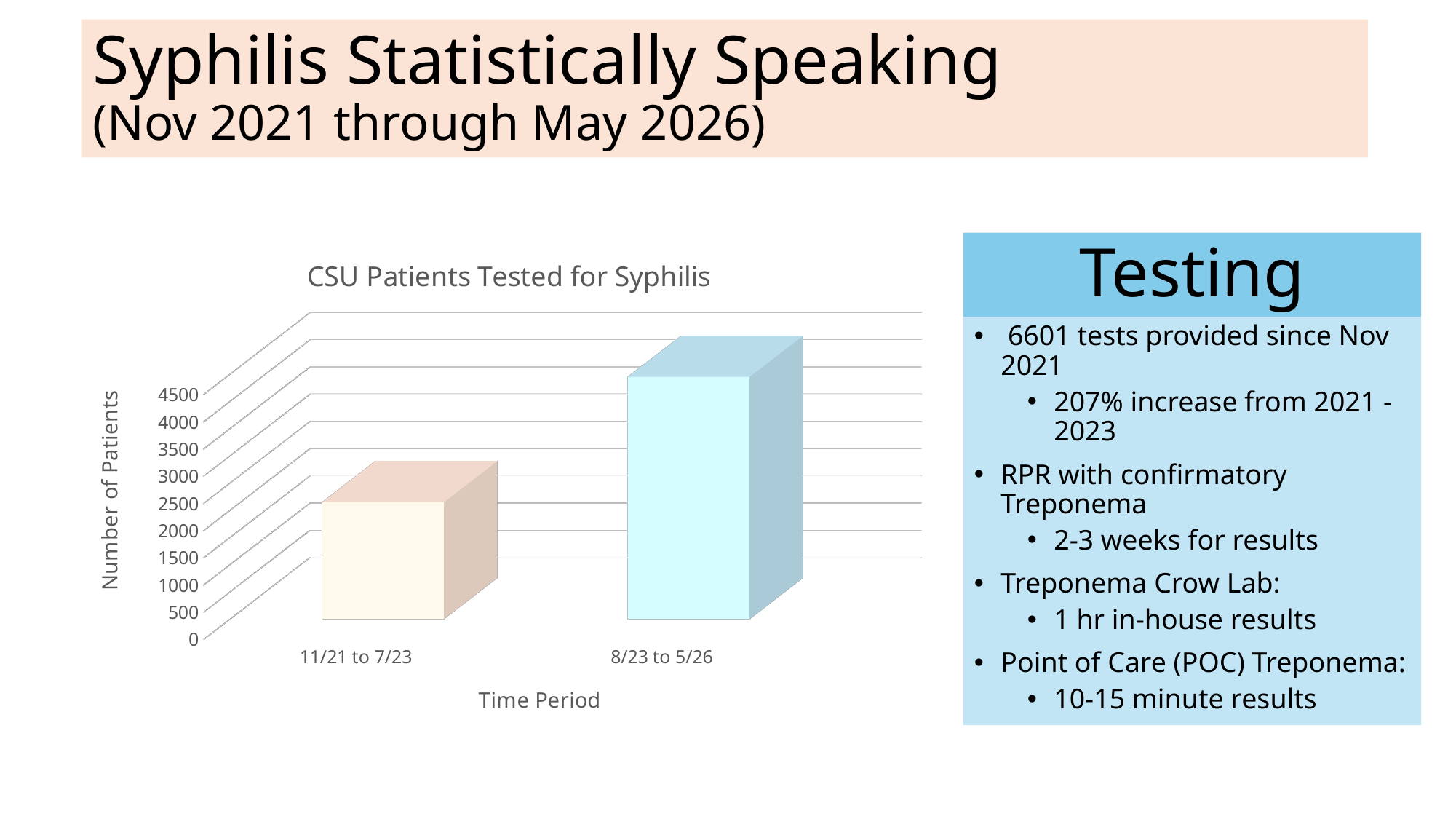
Which is larger, the value for 11/21 to 7/23 or the value for 8/23 to 5/26? 8/23 to 5/26 Do the values rise or fall from the first time period to the second? Rise What is the label of the vertical axis of the chart? Number of Patients Is the value for 11/21 to 7/23 greater or less than 3000? less How many time periods are plotted in the chart? 2 Which time period has the highest number of patients tested? 8/23 to 5/26 Is the value for 8/23 to 5/26 greater or less than 3000? greater What is the title of the chart? CSU Patients Tested for Syphilis Is the value for 11/21 to 7/23 greater or less than 1000? greater What kind of chart is shown on the slide? Bar chart Which time period has the lowest number of patients tested? 11/21 to 7/23